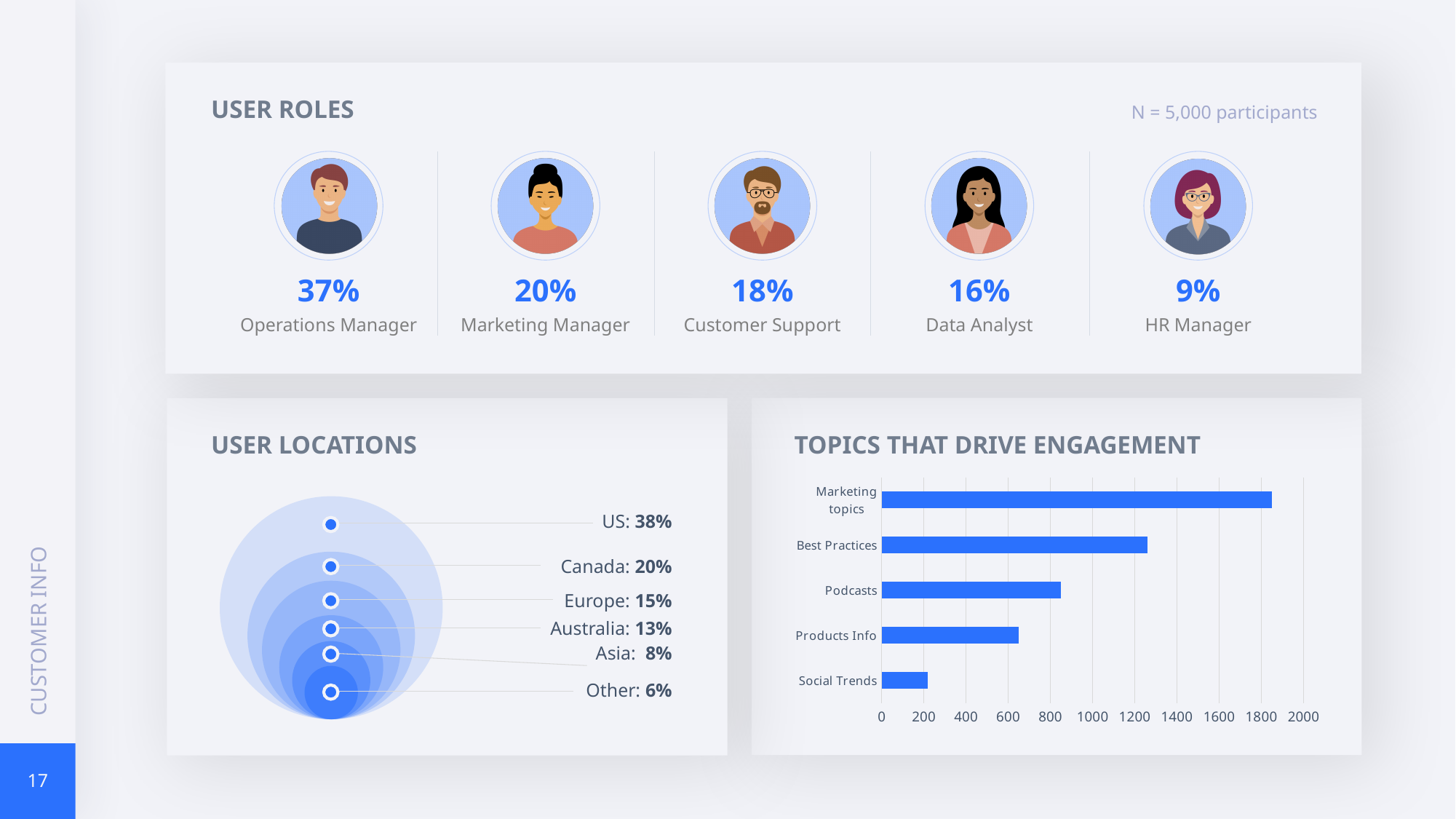
In the 'Topics That Drive Engagement' chart, which has a larger value, Podcasts or Products Info? Podcasts In the 'Topics That Drive Engagement' chart, what kind of chart is shown? bar chart In the 'Topics That Drive Engagement' chart, how many topics are plotted? 5 In the 'Topics That Drive Engagement' chart, is the value for Marketing topics greater or less than 1800? greater In the 'User Locations' section, what percentage of users are in Canada? 20% In the 'User Roles' section, what percentage of participants are Operations Managers? 37% In the 'Topics That Drive Engagement' chart, is the value for Social Trends greater or less than 400? less In the 'Topics That Drive Engagement' chart, is the value for Best Practices greater or less than 1200? greater In the 'Topics That Drive Engagement' chart, which topic has the lowest value? Social Trends In the 'Topics That Drive Engagement' chart, which topic has the highest value? Marketing topics In the 'User Roles' section, what is the difference between the Marketing Manager and HR Manager percentages? 11% In the 'User Locations' section, which location has the highest share of users? US